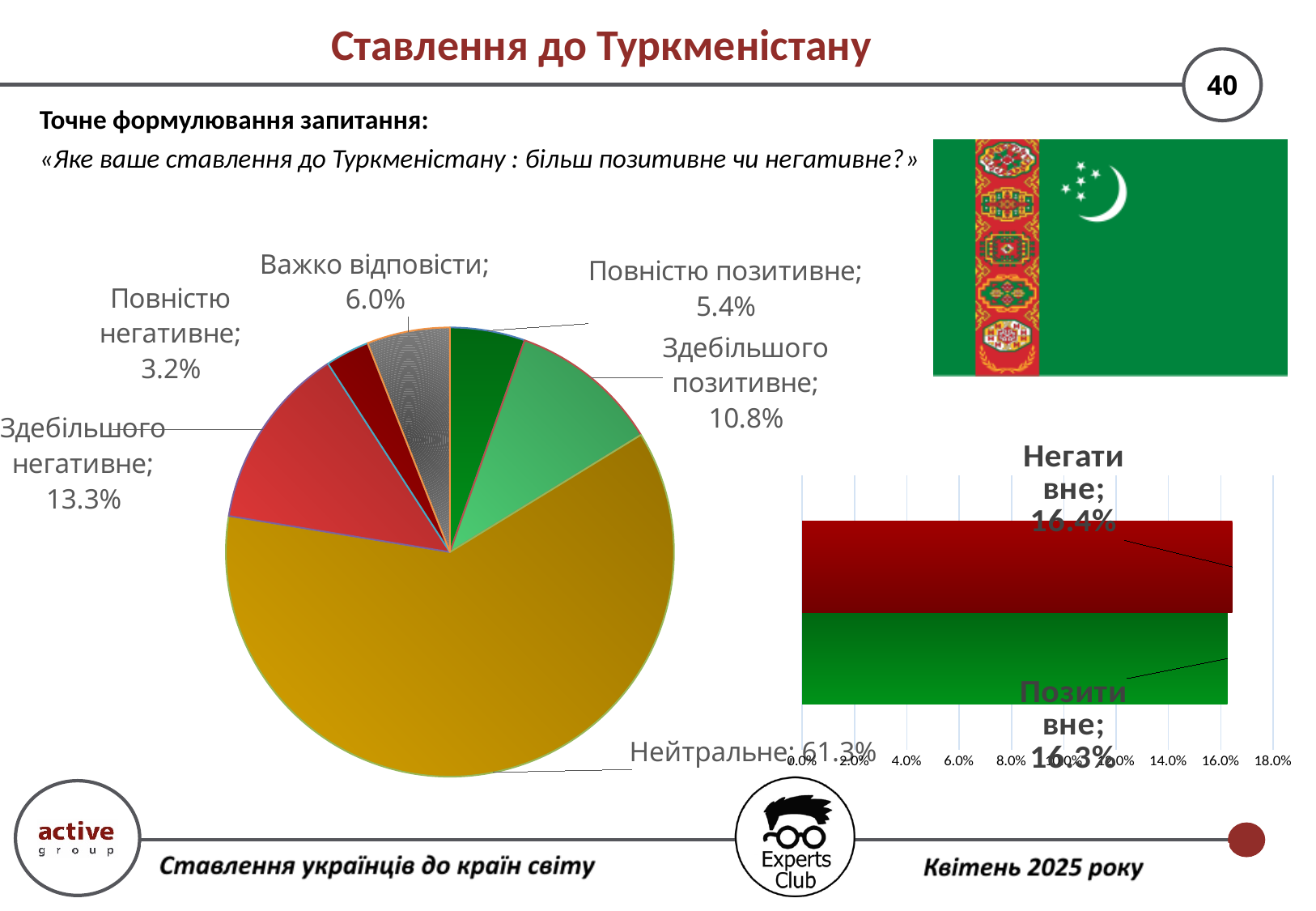
In the bar chart on the right, what is the value for «Позитивне»? 16.3% How many slices does the pie chart have? 6 In the pie chart, what is the value for «Здебільшого позитивне»? 10.8% In the bar chart on the right, what is the value for «Негативне»? 16.4% In the bar chart on the right, is the value for «Негативне» greater or less than 14.0%? greater In the pie chart, what share of respondents answered «Нейтральне»? 61.3% In the pie chart, which category has the smallest slice? Повністю негативне In the pie chart, what is the value for «Повністю негативне»? 3.2% In the pie chart, what is the difference between «Здебільшого негативне» and «Здебільшого позитивне»? 2.5% In the pie chart, which is larger: «Важко відповісти» or «Повністю позитивне»? Важко відповісти What type of chart is the chart on the left of the slide? Pie chart In the pie chart, which category has the largest slice? Нейтральне